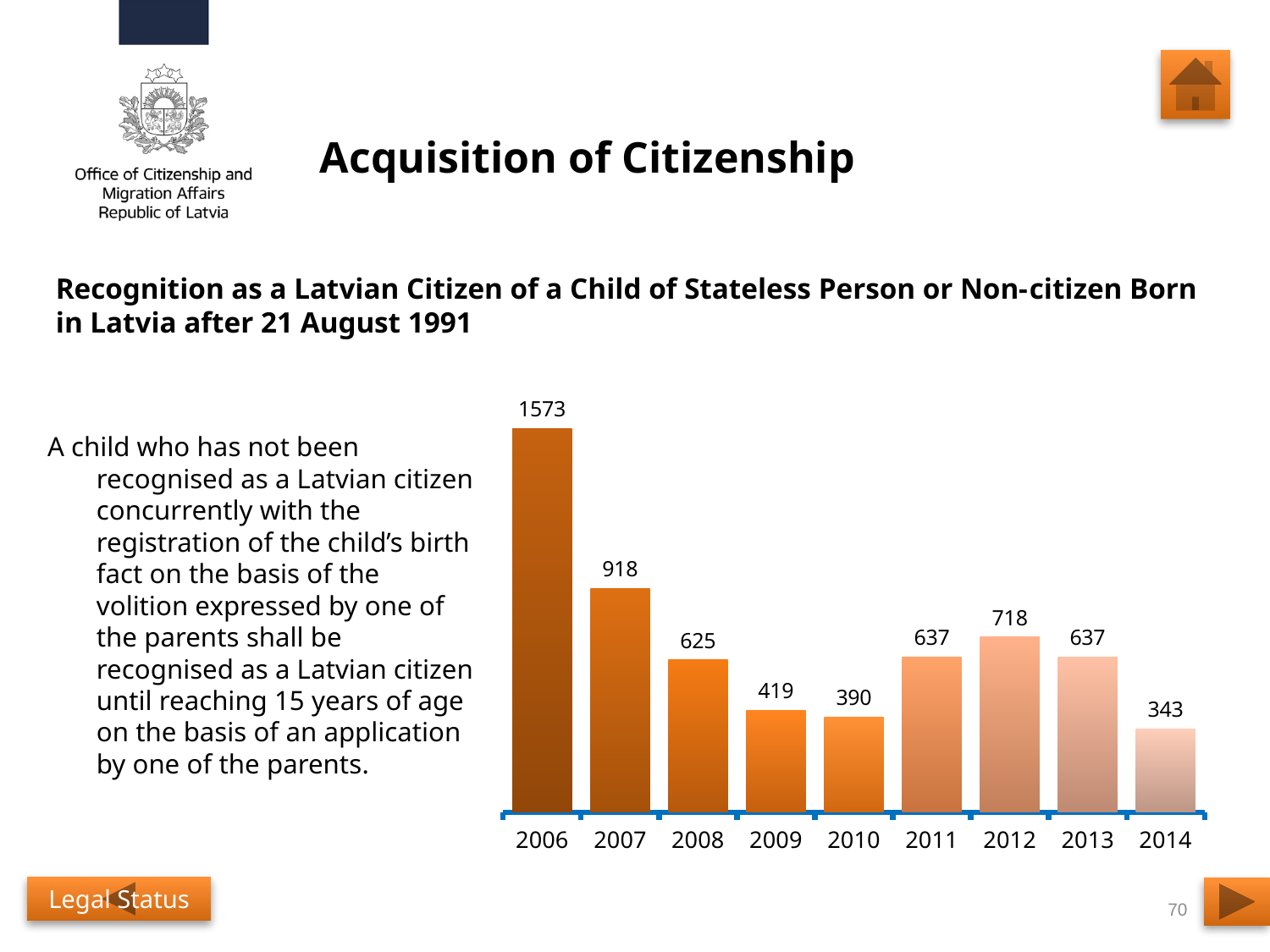
What is the value for 2010? 390 Which is larger, the value for 2008 or the value for 2009? 2008 What is the value for 2006? 1573 How many years are shown on the x axis? 9 What is the difference between the values for 2006 and 2007? 655 What is the difference between the values for 2012 and 2011? 81 Which two years have the same value of 637? 2011 and 2013 Which year has the lowest value? 2014 Which year has the highest value? 2006 Do the values rise or fall from 2006 to 2010? fall What is the value for 2014? 343 What kind of chart is shown? bar chart